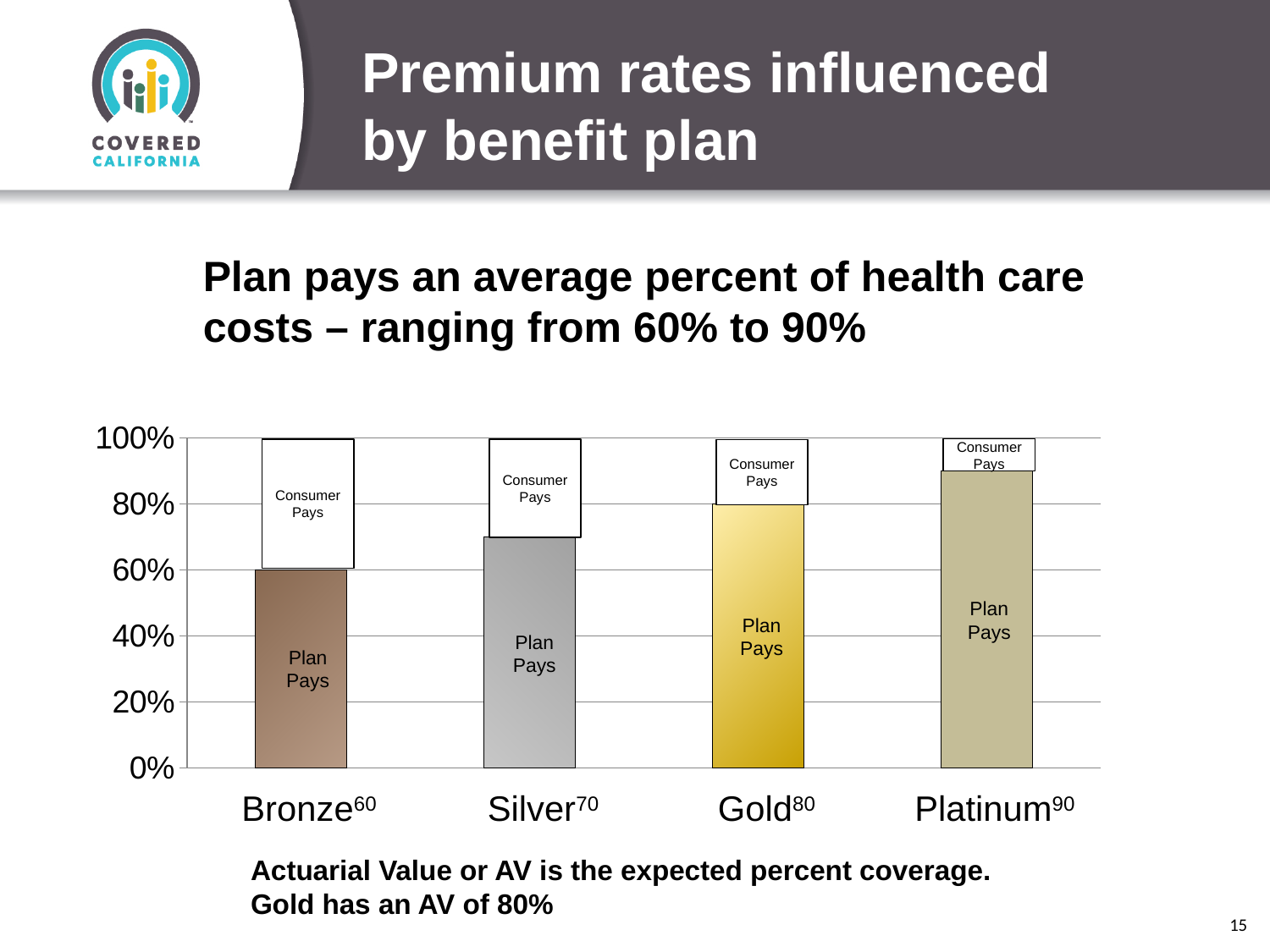
Which plan has the highest Plan Pays percentage? Platinum Do the Plan Pays values rise or fall moving from Bronze to Platinum along the x axis? rise Which plan has the lowest Plan Pays percentage? Bronze How many benefit plan categories are shown on the x axis of the chart? 4 What type of chart is shown on the slide? bar chart What percentage does the plan pay for the Bronze plan? 60% Which plan pays a larger share of costs, Gold or Silver? Gold Is the Plan Pays value for Silver greater or less than 60%? greater What percentage does the plan pay for the Gold plan? 80% What is the difference between the Plan Pays percentage for Gold and for Bronze? 20% Is the Plan Pays value for Silver greater or less than 80%? less Is the Plan Pays value for Platinum greater or less than 80%? greater